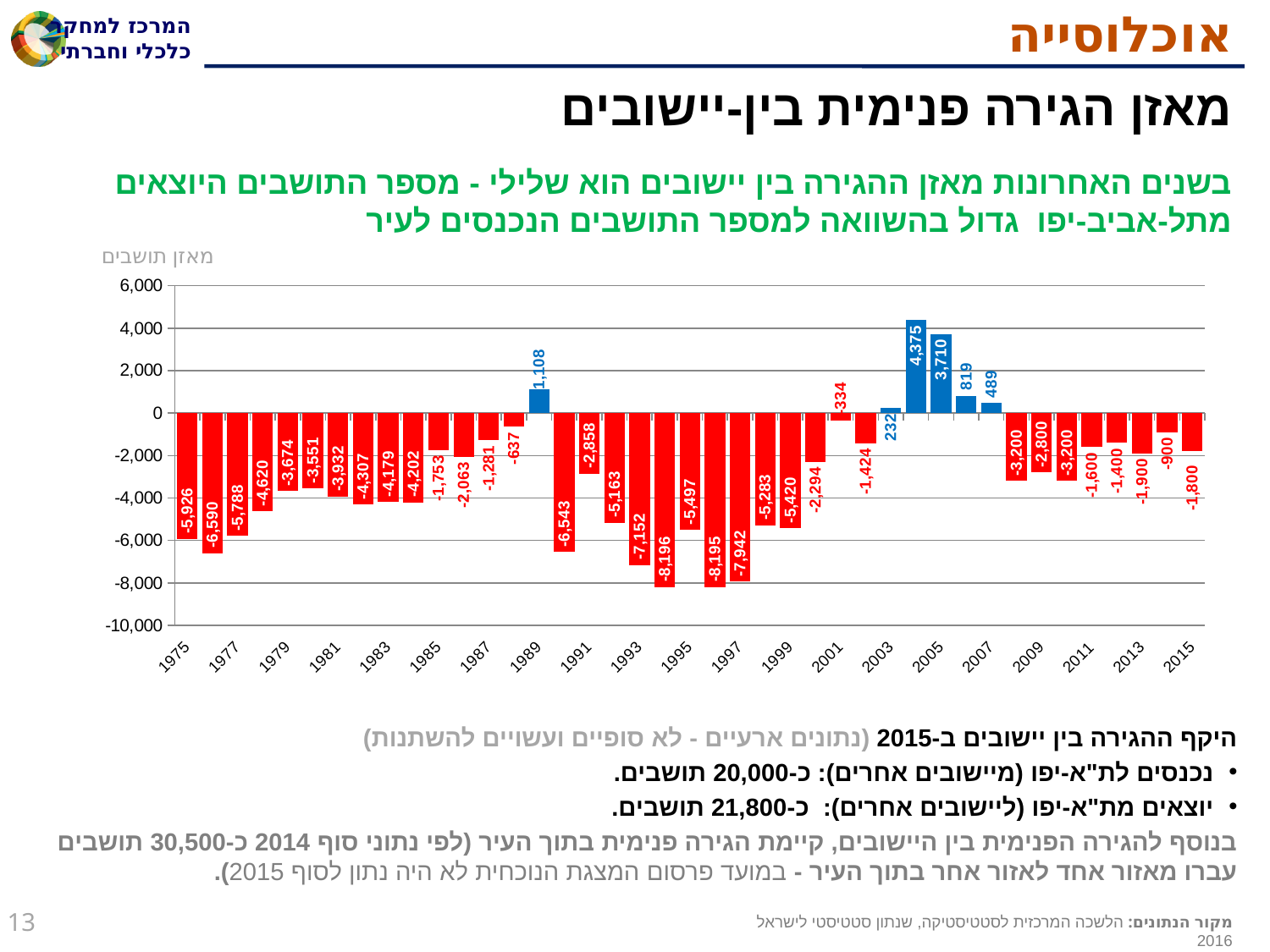
What is the value for 1975? -5,926 What is the value for 2004? 4,375 How many years are plotted on the chart? 41 What is the difference between the values for 2004 and 2005? 665 What is the label shown above the vertical axis? מאזן תושבים Do the values rise or fall from 2004 to 2007? fall What is the value for 2015? -1,800 Which year has the highest value? 2004 What kind of chart is shown? bar chart What is the value for 2014? -900 Is the value for 1994 greater or less than -8,000? less Which is larger, the value for 1989 or the value for 2007? 1989